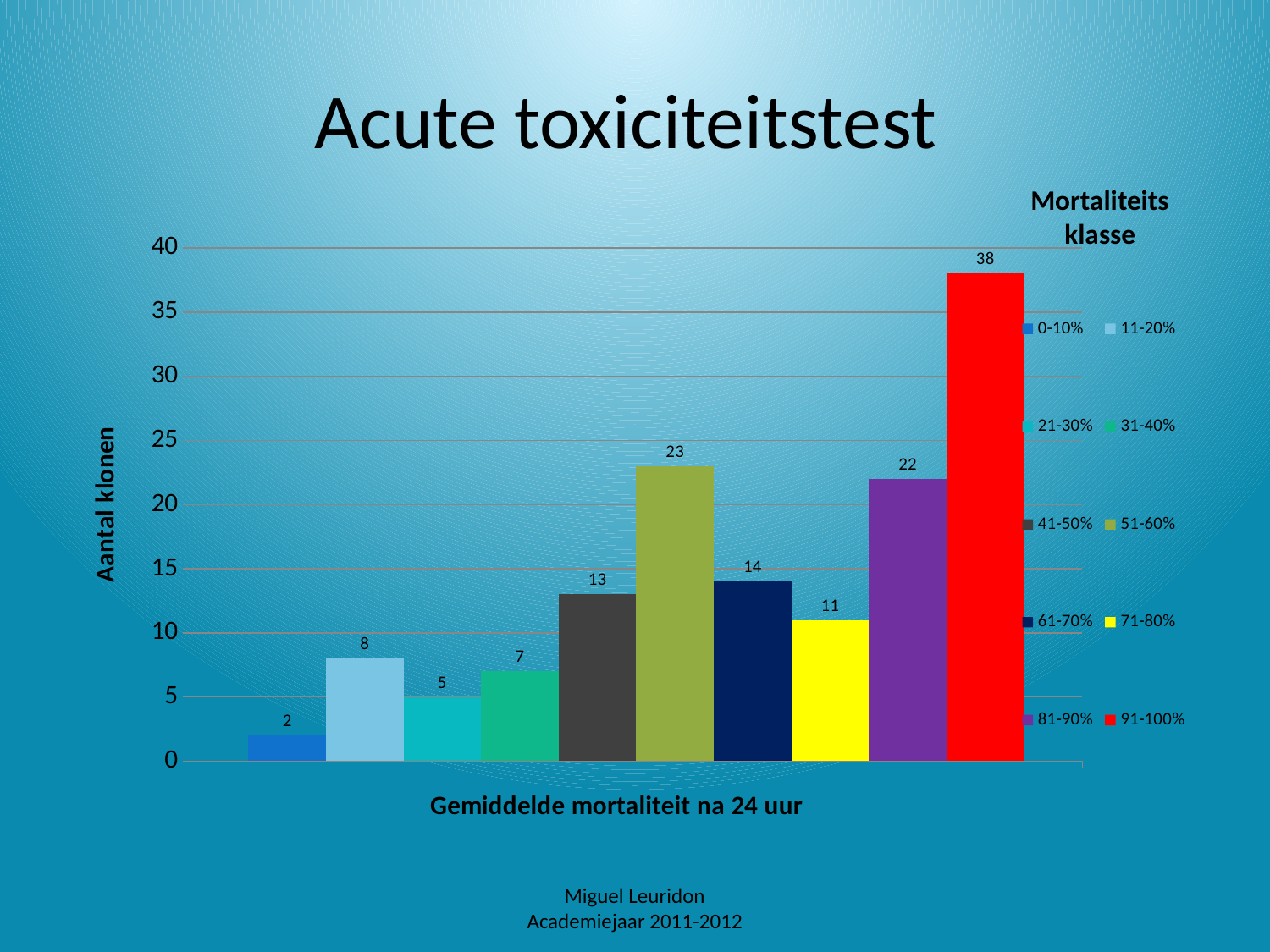
How many bars are plotted in the chart? 10 What is the label of the horizontal axis? Gemiddelde mortaliteit na 24 uur What is the value for the 51-60% mortality class? 23 What is the difference between the values for the 91-100% and 81-90% mortality classes? 16 What type of chart is shown on the slide? bar chart Which has a larger value, the 41-50% class or the 61-70% class? 61-70% Which mortality class has the lowest number of clones? 0-10% Which mortality class has the highest number of clones? 91-100% What is the number of clones (Aantal klonen) for the 91-100% mortality class? 38 How many mortality classes does the legend list? 10 What is the value for the 0-10% mortality class? 2 What is the label of the vertical axis? Aantal klonen